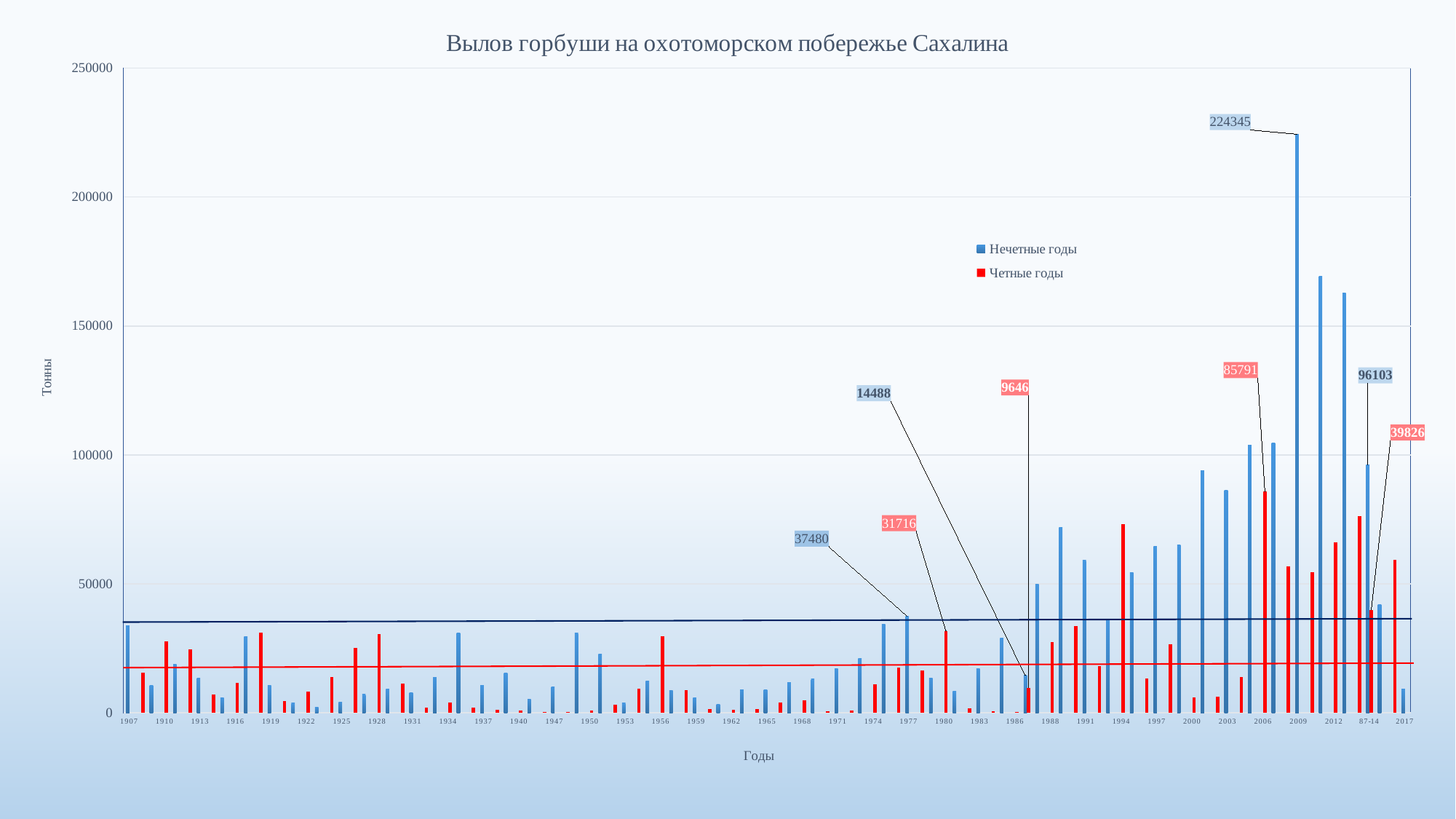
What is the catch value labelled for 1980? 31716 What is the catch value labelled for 2009? 224345 What is the catch value labelled for 1977? 37480 What is the title of the chart? Вылов горбуши на охотоморском побережье Сахалина Is the value for 1994 greater or less than 50000? greater Is the value for 1907 greater or less than 50000? less What is the difference between the labelled values for 2009 and 2006? 138554 Which year has the highest catch in the chart? 2009 What kind of chart is shown on the slide? Bar chart How many series does the legend list? 2 What is the catch value labelled for 2006? 85791 What are the two series named in the legend? Нечетные годы and Четные годы